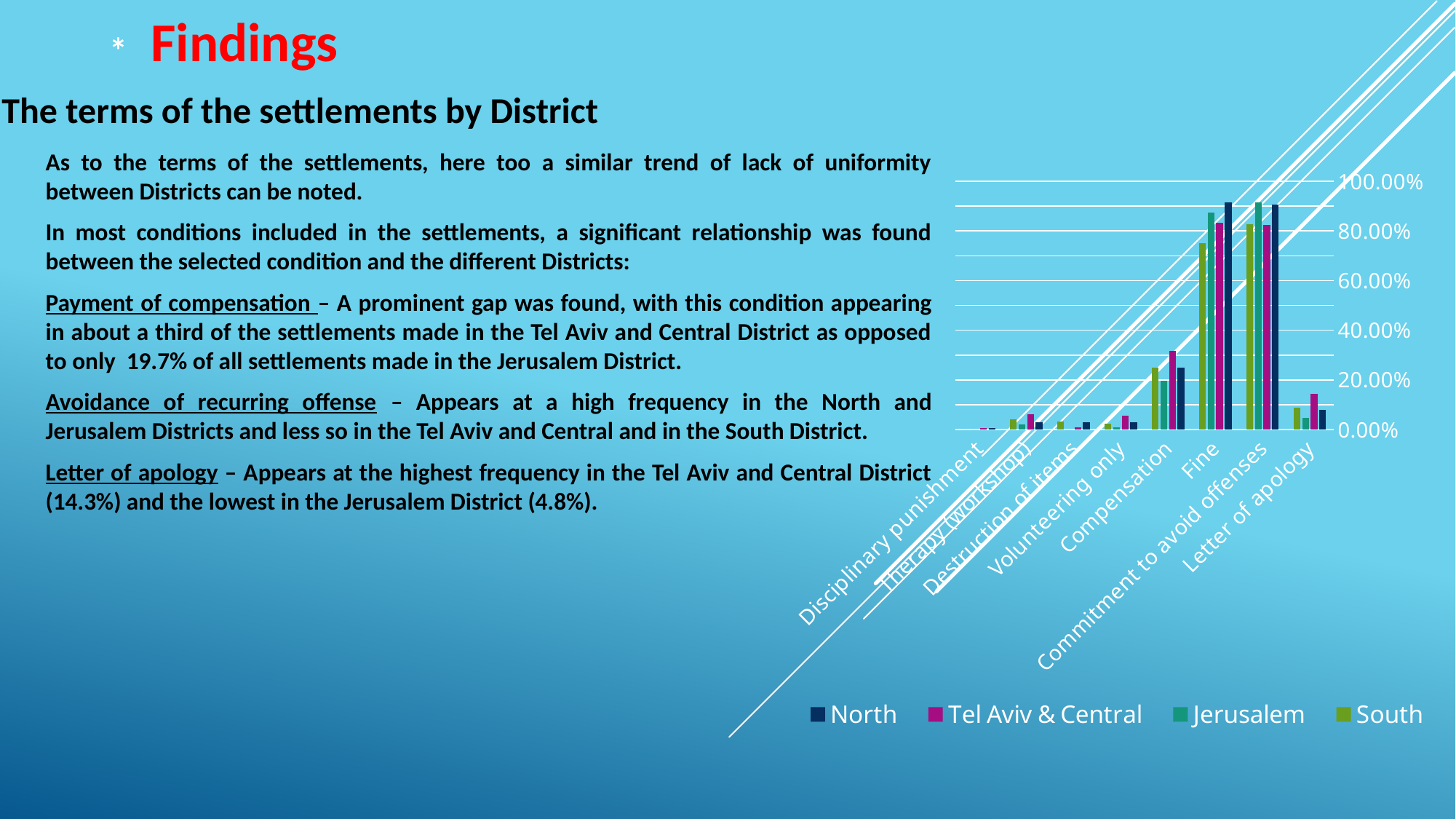
Which series has the lowest value in the Letter of apology category? Jerusalem Is the value for Tel Aviv & Central in the Letter of apology category greater or less than 20.00%? less Is the value for Jerusalem in the Commitment to avoid offenses category greater or less than 60.00%? greater Which is larger for the North series: the value for Fine or the value for Letter of apology? Fine Which category has the lowest values across all districts? Disciplinary punishment How many series does the chart legend list? 4 What kind of chart is shown on the slide? Bar chart Which series has the highest value in the Compensation category? Tel Aviv & Central Is the value for North in the Fine category greater or less than 60.00%? greater How many categories are shown on the x axis of the chart? 8 Which series are listed in the chart legend? North, Tel Aviv & Central, Jerusalem, South